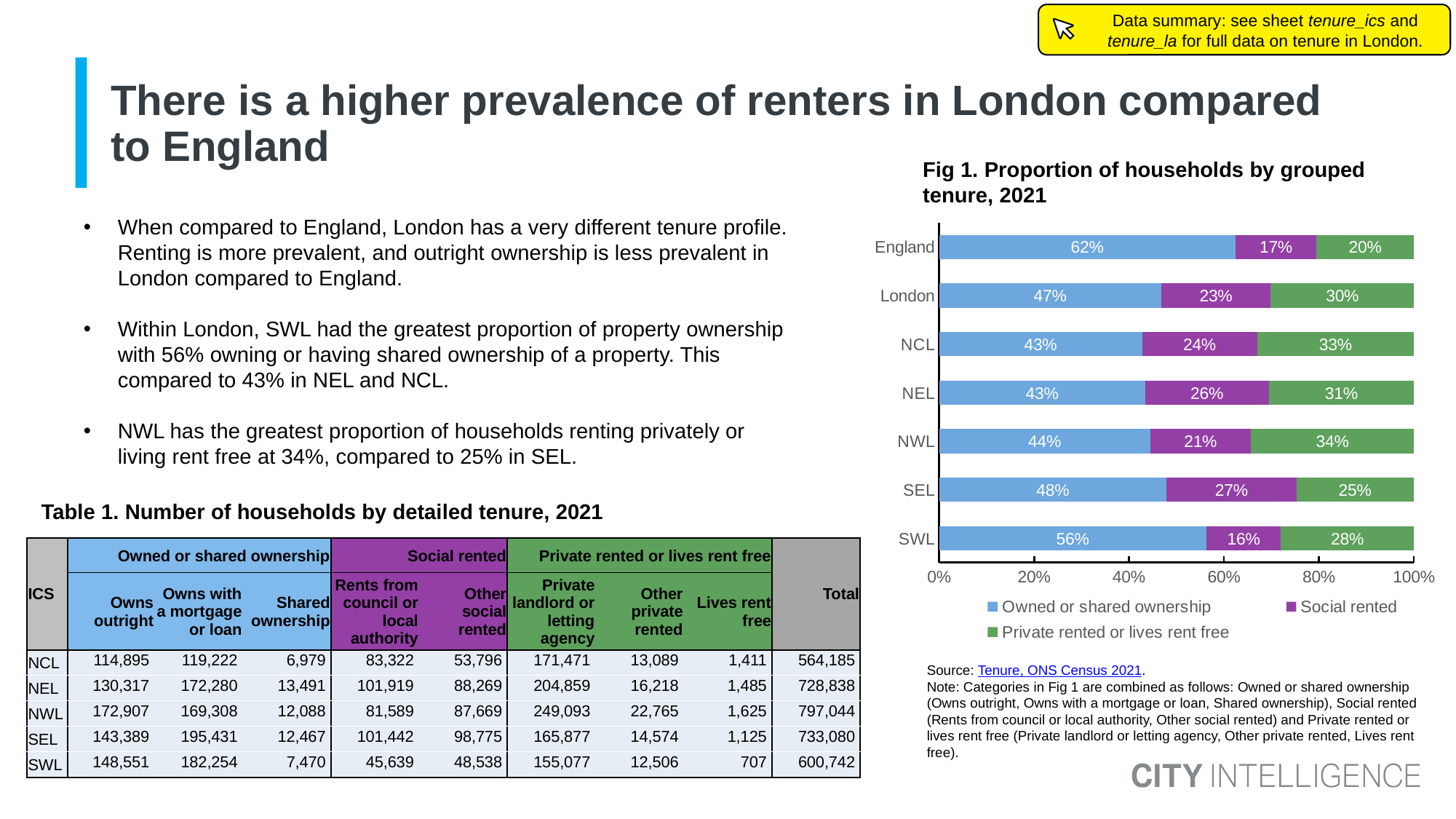
What colour represents Social rented in Fig 1? Purple In Fig 1, which has a larger Private rented or lives rent free value, NCL or SEL? NCL In Fig 1, what is the Owned or shared ownership value for London? 47% In Fig 1, what is the Social rented value for SEL? 27% How many series does the legend of Fig 1 list? 3 How many categories are shown on the y axis of Fig 1? 7 In Fig 1, what is the difference between the Owned or shared ownership values for England and London? 15% In Fig 1, what is the total of the stacked bar for NEL? 100% In Fig 1, what is the Private rented or lives rent free value for NWL? 34% In Fig 1, which category has the highest Owned or shared ownership value? England What type of chart is Fig 1? Stacked bar chart In Fig 1, which category has the lowest Social rented value? SWL